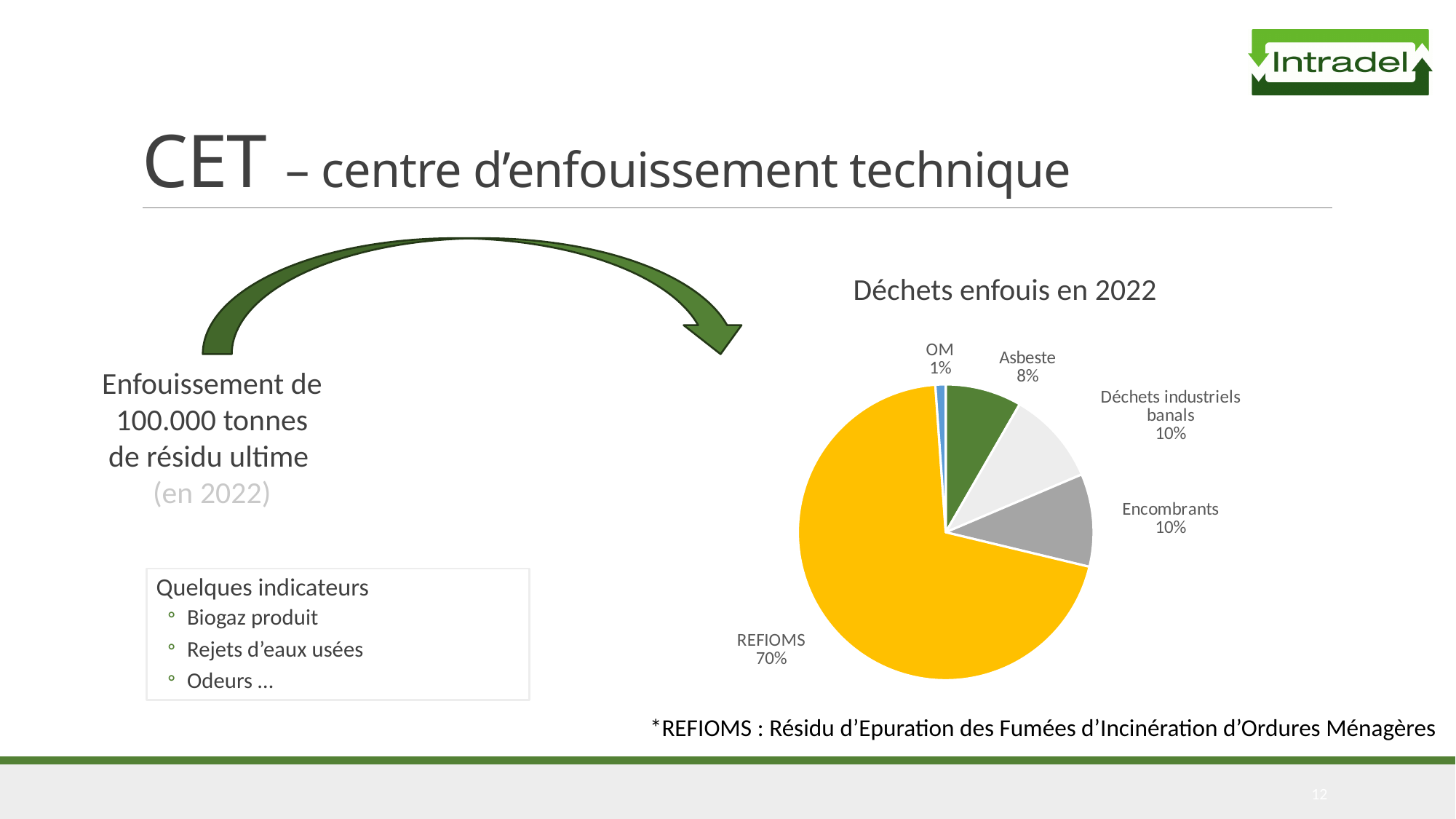
What is the value shown for Asbeste? 8% What is the title of the chart? Déchets enfouis en 2022 What kind of chart is shown on the slide? pie chart What is the value shown for Encombrants? 10% What share of the pie does REFIOMS represent? 70% What colour is the REFIOMS slice? yellow What is the difference between the shares of REFIOMS and Déchets industriels banals? 60% Which is larger, the share for Asbeste or the share for Encombrants? Encombrants What is the value shown for OM? 1% Which category has the largest slice of the pie? REFIOMS Which category has the smallest slice of the pie? OM How many categories are shown in the pie chart? 5